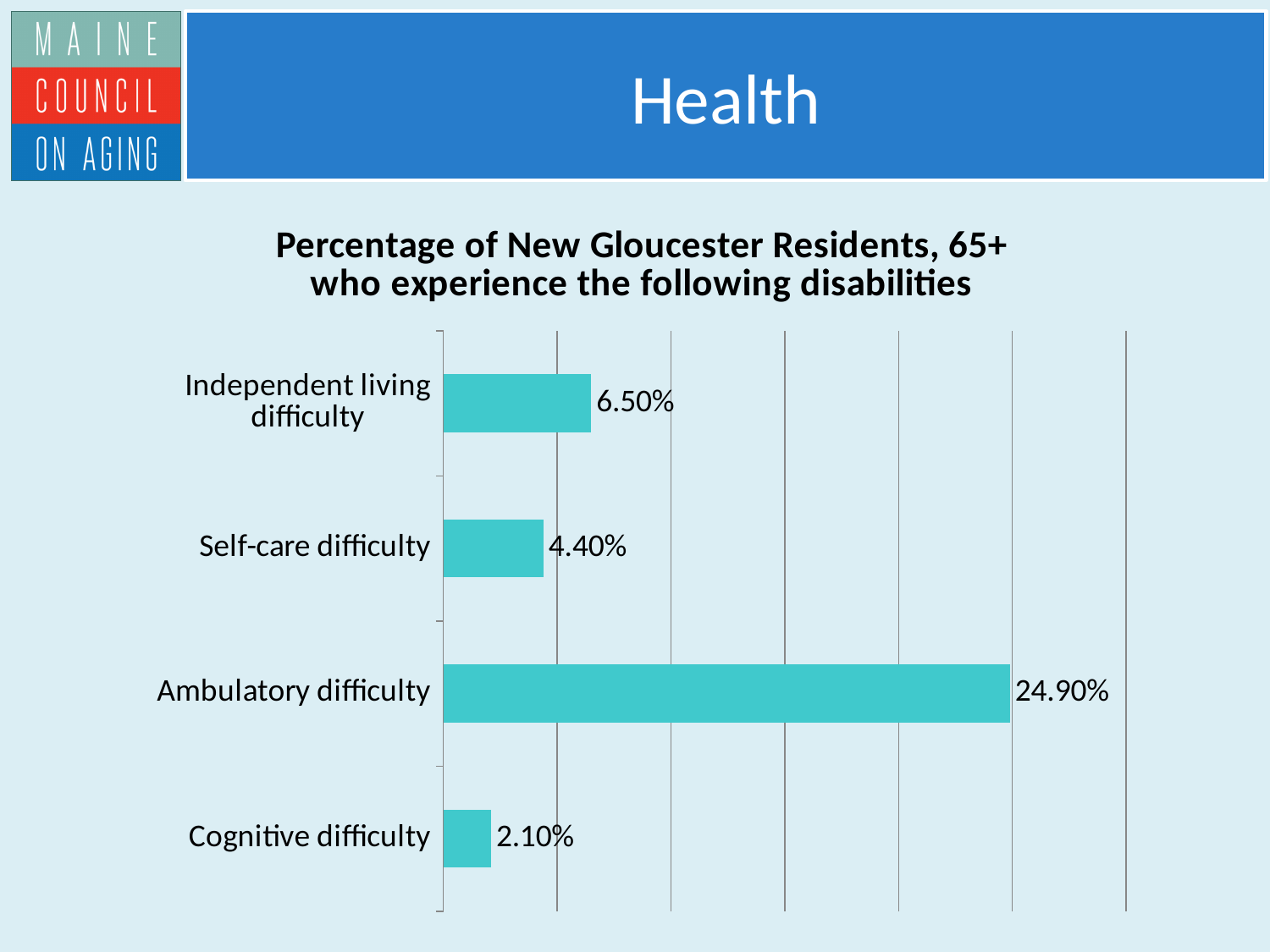
What is the title of the chart? Percentage of New Gloucester Residents, 65+ who experience the following disabilities How many disability categories are shown in the chart? 4 Which disability category has the highest percentage? Ambulatory difficulty What is the value shown for Independent living difficulty? 6.50% What percentage of New Gloucester residents 65+ experience ambulatory difficulty? 24.90% Which is larger, the value for Self-care difficulty or the value for Cognitive difficulty? Self-care difficulty What is the value shown for Cognitive difficulty? 2.10% Which disability category has the lowest percentage? Cognitive difficulty What is the value shown for Self-care difficulty? 4.40% What kind of chart is shown on the slide? Bar chart What is the difference between the percentages for Ambulatory difficulty and Independent living difficulty? 18.40% What is the difference between the percentages for Independent living difficulty and Self-care difficulty? 2.10%